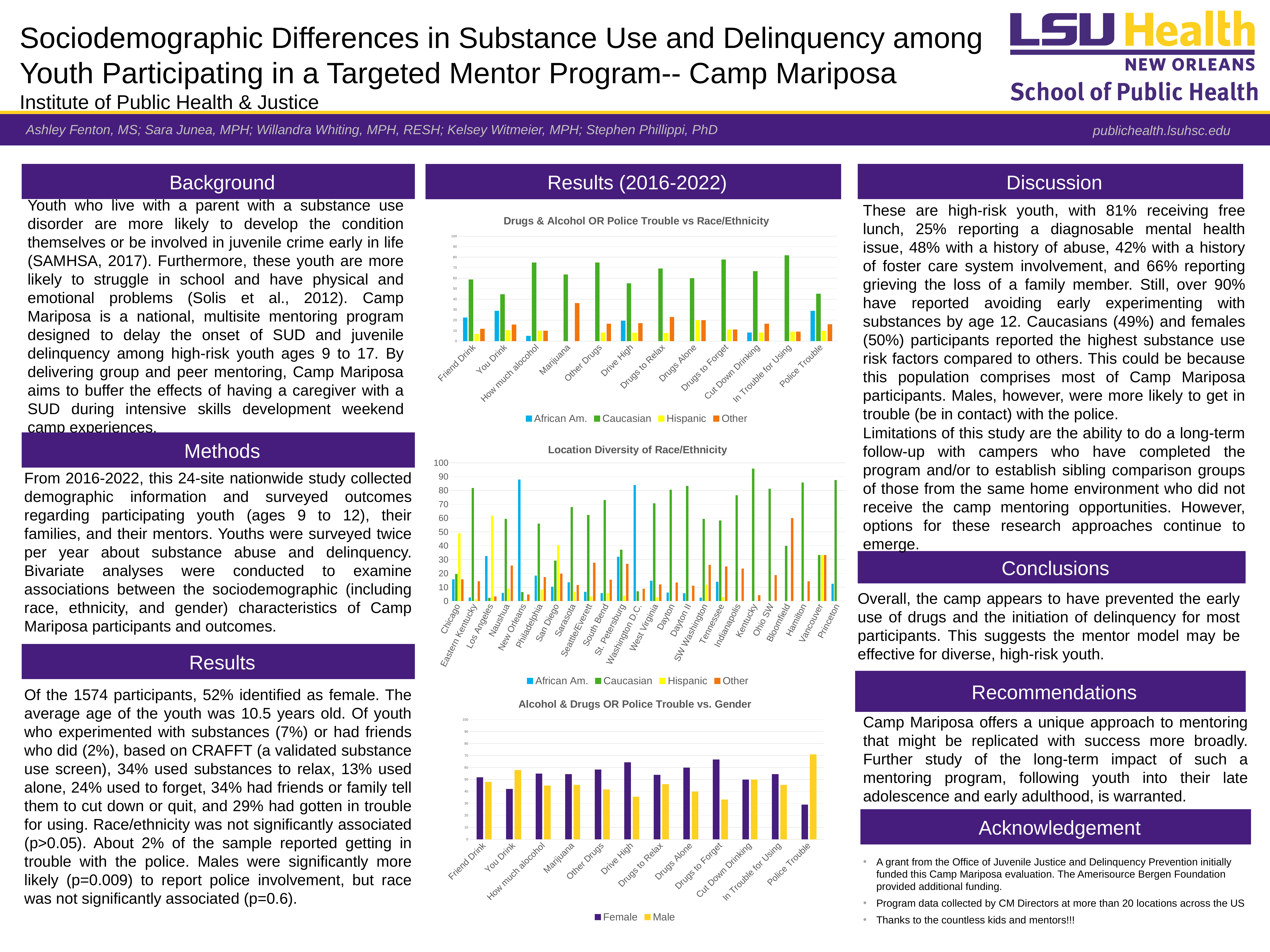
In the 'Location Diversity of Race/Ethnicity' chart, how many locations are shown on the x axis? 24 In the 'Drugs & Alcohol OR Police Trouble vs Race/Ethnicity' chart, which series has the highest value for 'In Trouble for Using'? Caucasian In the 'Drugs & Alcohol OR Police Trouble vs Race/Ethnicity' chart, which is larger for 'Police Trouble': the African Am. value or the Caucasian value? Caucasian In the 'Location Diversity of Race/Ethnicity' chart, which series has the highest value for 'New Orleans'? African Am. In the 'Location Diversity of Race/Ethnicity' chart, which series has the highest value for 'Los Angeles'? Hispanic In the 'Drugs & Alcohol OR Police Trouble vs Race/Ethnicity' chart, how many series does the legend list? 4 In the 'Alcohol & Drugs OR Police Trouble vs. Gender' chart, which is larger for 'Police Trouble': the Female value or the Male value? Male In the 'Alcohol & Drugs OR Police Trouble vs. Gender' chart, is the Female value for 'Drugs to Forget' greater or less than 60? greater In the 'Location Diversity of Race/Ethnicity' chart, is the Caucasian value for 'Kentucky' greater or less than 90? greater What kind of chart is 'Location Diversity of Race/Ethnicity'? bar chart In the 'Alcohol & Drugs OR Police Trouble vs. Gender' chart, how many series does the legend list? 2 In the 'Drugs & Alcohol OR Police Trouble vs Race/Ethnicity' chart, is the Caucasian value for 'Marijuana' greater or less than 50? greater